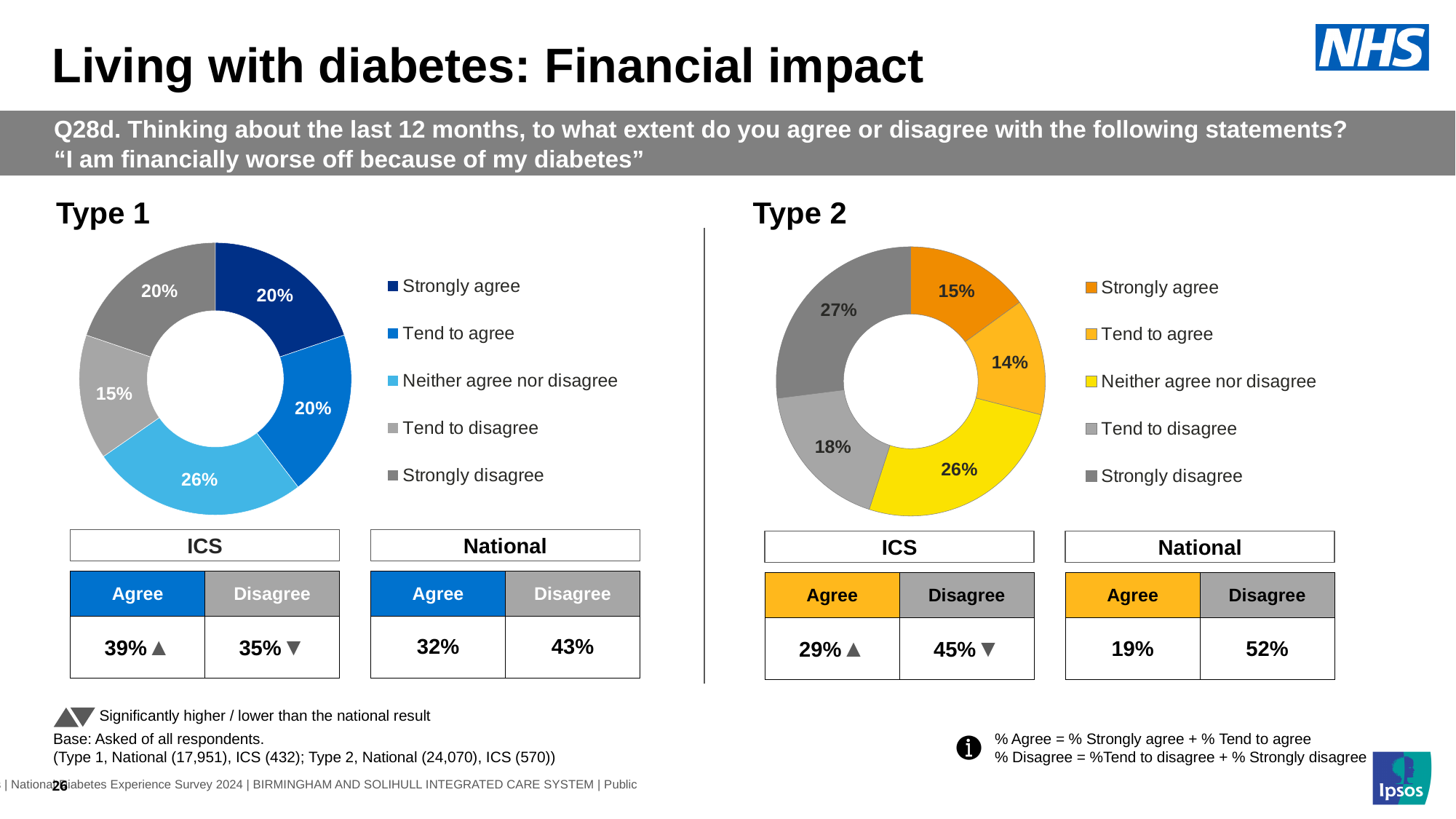
In the Type 2 chart, which response category has the largest share? Strongly disagree In the Type 1 chart, which response category has the smallest share? Tend to disagree In the Type 1 chart, what percentage of respondents said 'Neither agree nor disagree'? 26% In the Type 2 chart, what percentage of respondents said 'Tend to agree'? 14% In the Type 2 chart, which response category has the smallest share? Tend to agree In the Type 1 chart, what percentage of respondents said 'Tend to disagree'? 15% In the Type 2 chart, what is the difference between the 'Strongly disagree' and 'Strongly agree' shares? 12 percentage points In the Type 2 chart, what percentage of respondents said 'Strongly disagree'? 27% In the Type 1 chart, which is larger: 'Neither agree nor disagree' or 'Tend to disagree'? Neither agree nor disagree What type of chart is used for Type 2? Donut (pie) chart How many response categories does the legend of the Type 1 chart list? 5 In the Type 2 chart, what colour represents 'Neither agree nor disagree'? Yellow